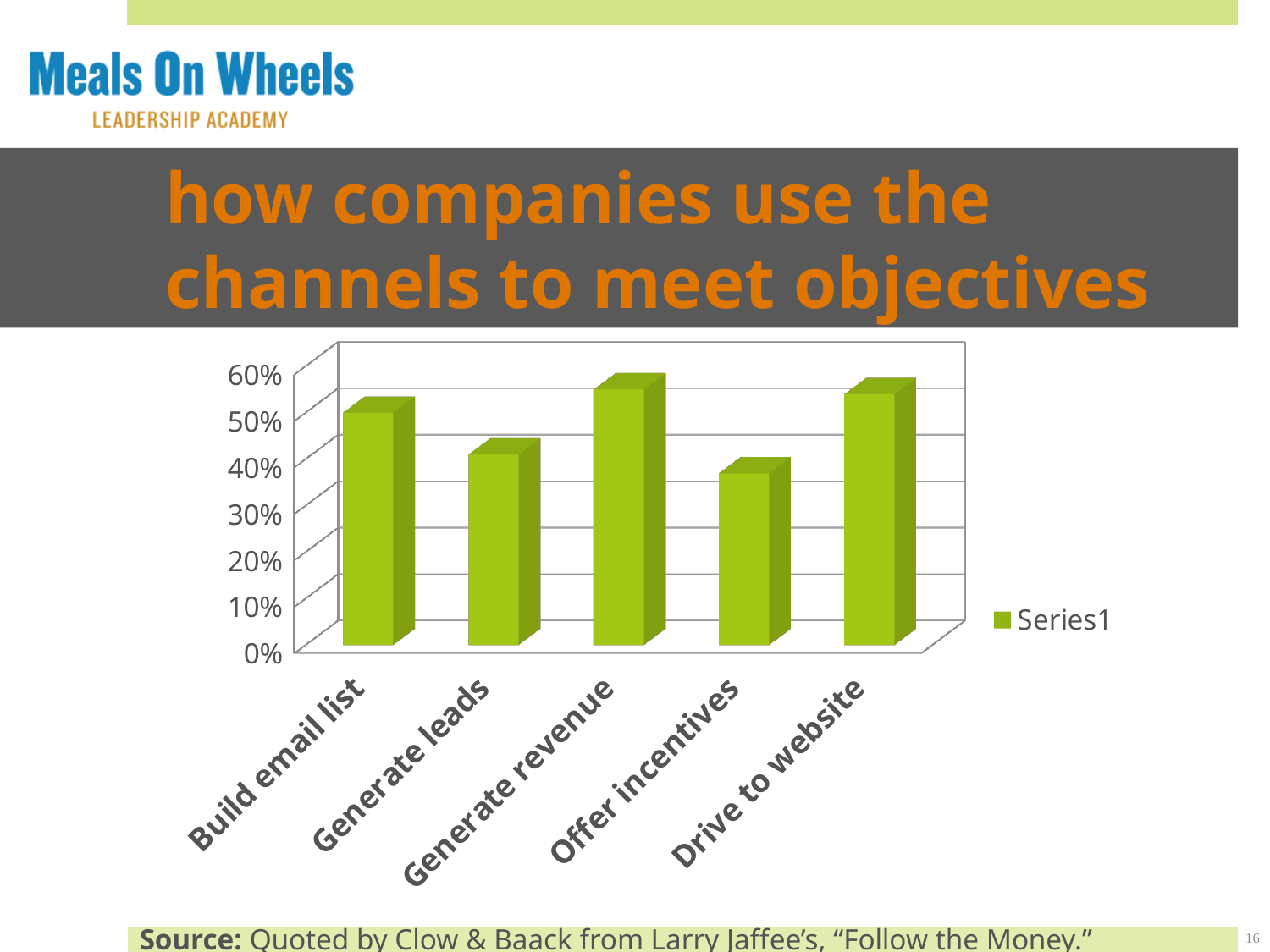
Is the value for Build email list greater or less than 40%? greater Is the value for Generate revenue greater or less than 50%? greater What is the name of the series shown in the chart's legend? Series1 Which is larger, the value for Drive to website or the value for Generate leads? Drive to website How many categories are shown on the x axis of the chart? 5 How many series does the chart's legend list? 1 Which is larger, the value for Generate revenue or the value for Offer incentives? Generate revenue What kind of chart is shown on the slide? bar chart Which is larger, the value for Build email list or the value for Generate leads? Build email list Is the value for Generate leads greater or less than 50%? less Which category has the lowest value in the chart? Offer incentives